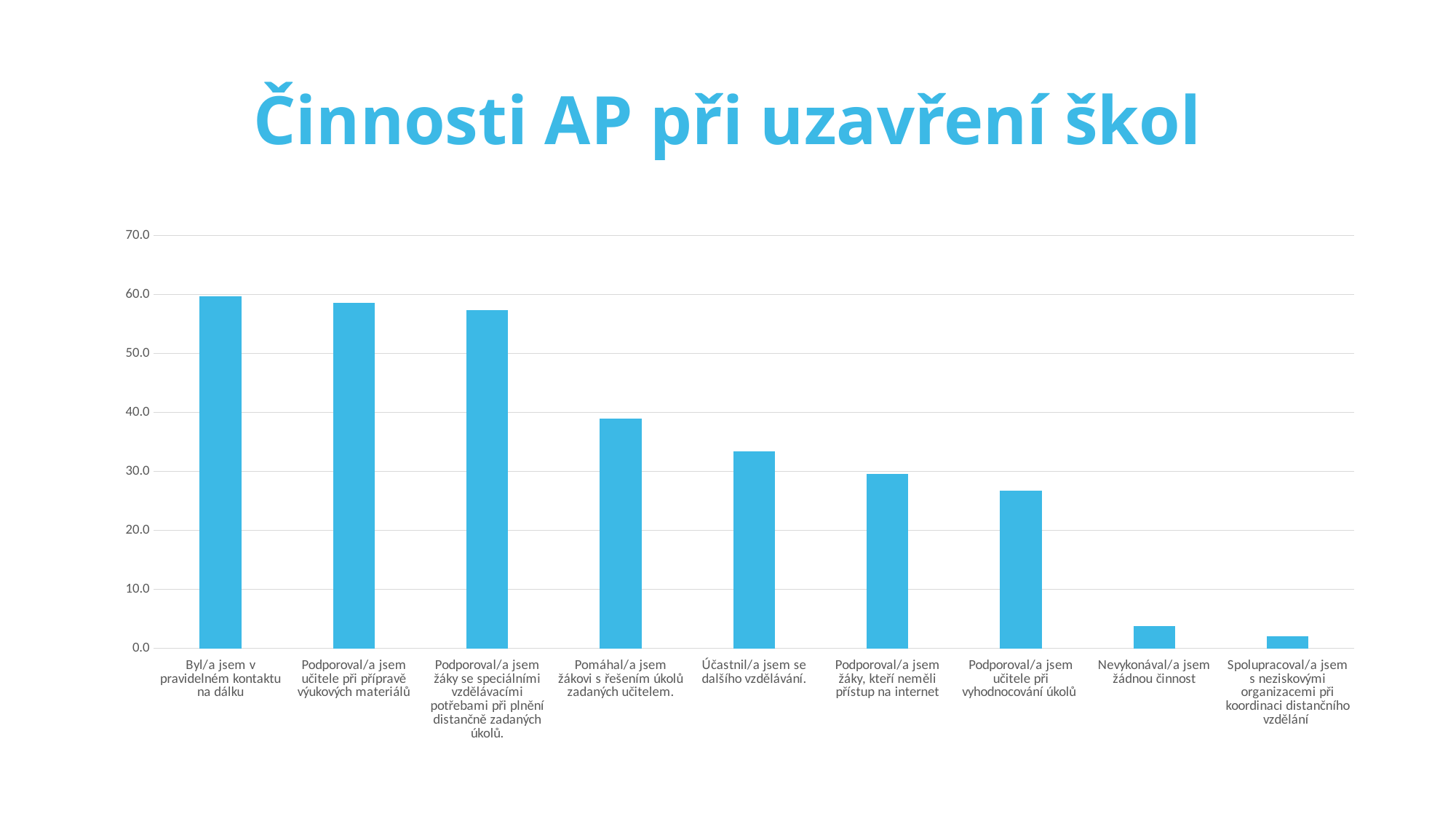
Is the value for "Spolupracoval/a jsem s neziskovými organizacemi při koordinaci distančního vzdělání" greater or less than 10.0? less Is the value for "Byl/a jsem v pravidelném kontaktu na dálku" greater or less than 50.0? greater What is the title of the chart? Činnosti AP při uzavření škol How many categories (bars) are shown in the chart? 9 Is the value for "Pomáhal/a jsem žákovi s řešením úkolů zadaných učitelem." greater or less than 30.0? greater Which has the larger value: "Pomáhal/a jsem žákovi s řešením úkolů zadaných učitelem." or "Účastnil/a jsem se dalšího vzdělávání."? Pomáhal/a jsem žákovi s řešením úkolů zadaných učitelem. Do the bar values rise or fall from left to right along the x axis? fall Which has the larger value: "Podporoval/a jsem učitele při přípravě výukových materiálů" or "Podporoval/a jsem učitele při vyhodnocování úkolů"? Podporoval/a jsem učitele při přípravě výukových materiálů What type of chart is shown on the slide? bar chart